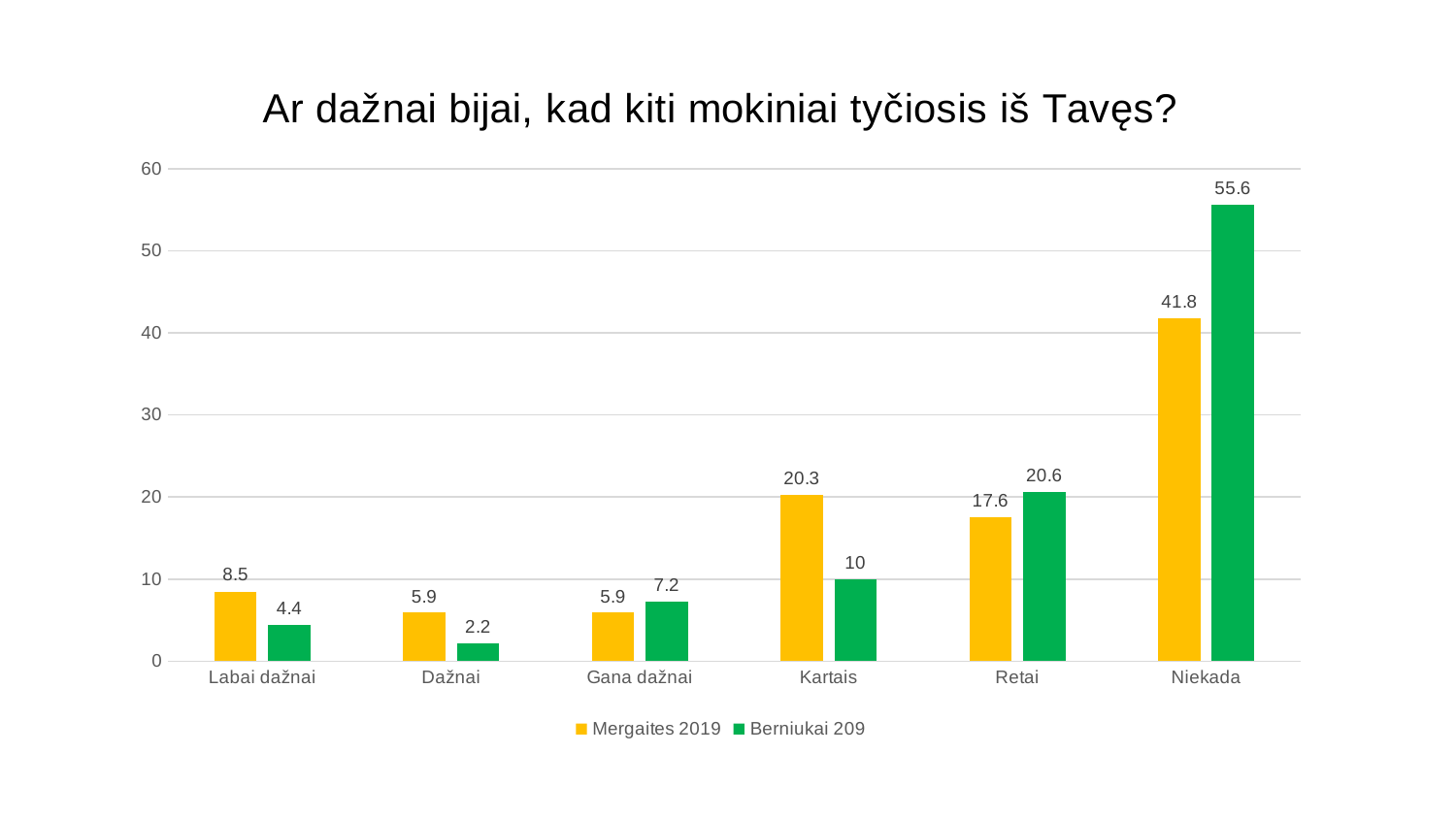
What is the value for Berniukai 209 in the Dažnai category? 2.2 What kind of chart is shown on the slide? bar chart What is the value for Mergaites 2019 in the Niekada category? 41.8 Which category has the highest value for Berniukai 209? Niekada What is the title of the chart? Ar dažnai bijai, kad kiti mokiniai tyčiosis iš Tavęs? How many categories are shown on the x axis? 6 Which category has the lowest value for Berniukai 209? Dažnai Is the value for Mergaites 2019 in the Kartais category greater or less than 30? less What is the value for Berniukai 209 in the Kartais category? 10 In the Labai dažnai category, which series has the larger value, Mergaites 2019 or Berniukai 209? Mergaites 2019 How many series does the legend list? 2 What is the difference between Berniukai 209 and Mergaites 2019 in the Niekada category? 13.8